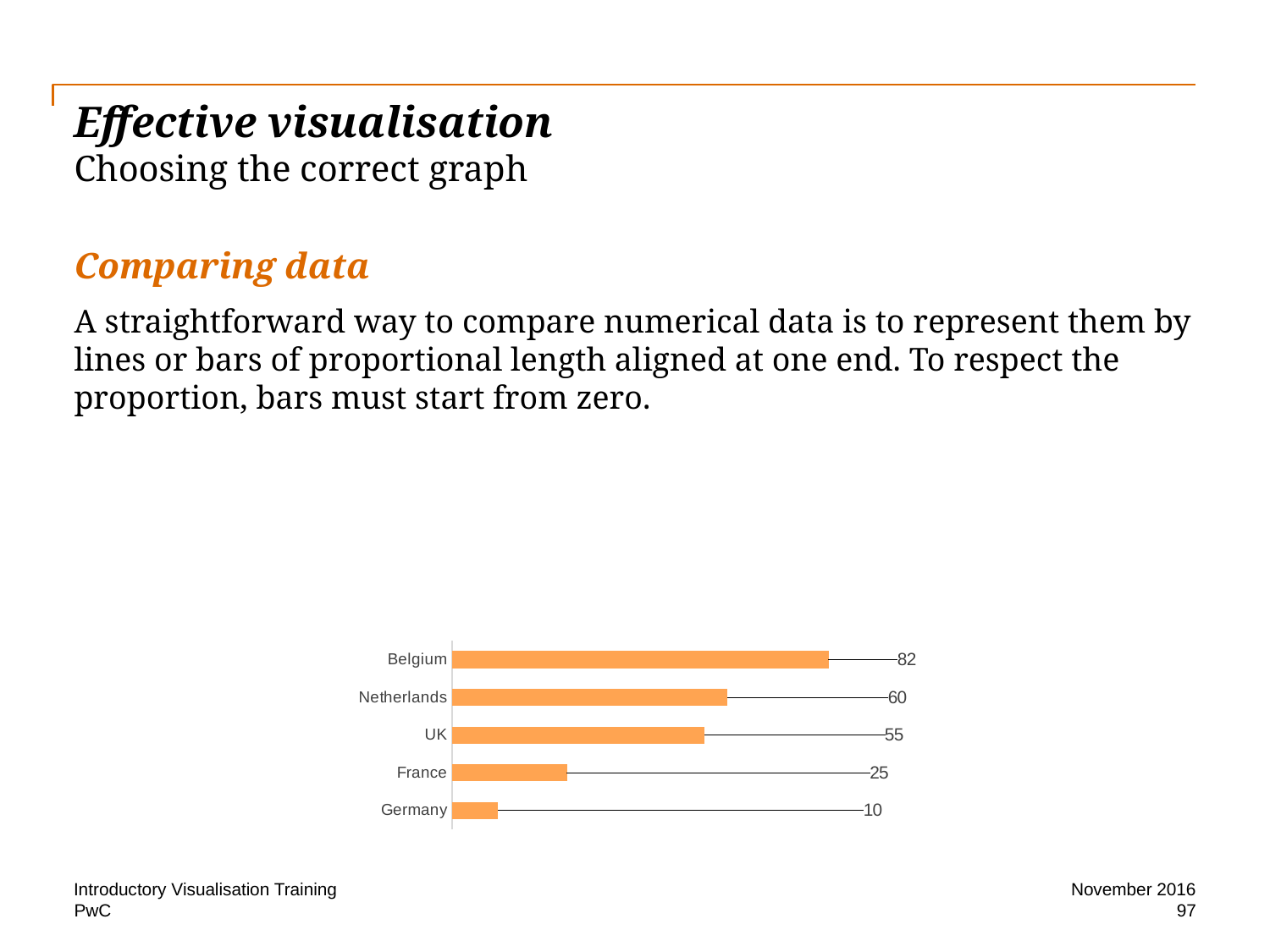
What is the value for Netherlands? 60 What is the value for France? 25 What is the value for UK? 55 What kind of chart is shown on the slide? Bar chart How many categories are shown in the chart? 5 What is the difference between the values for France and Germany? 15 What is the value for Germany? 10 What is the value for Belgium? 82 Which category has the highest value? Belgium What is the difference between the values for Belgium and Netherlands? 22 Which category has the lowest value? Germany Which is larger, the value for Netherlands or the value for UK? Netherlands